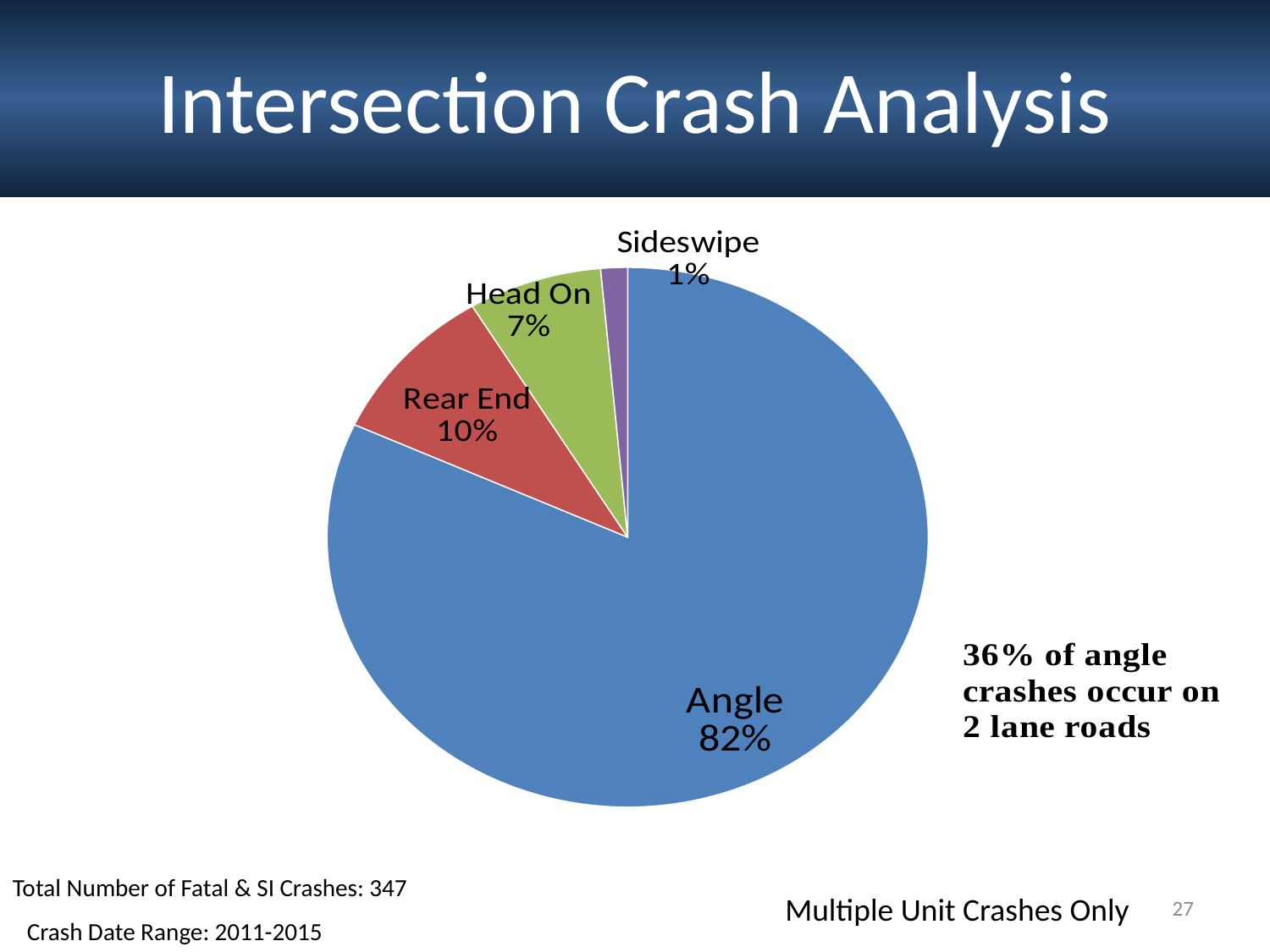
How many slices does the pie chart have? 4 Which crash type has the smallest slice of the pie? Sideswipe What share of the pie does Head On represent? 7% What is the difference in percentage points between Head On and Sideswipe? 6 What colour is the Angle slice of the pie? blue What share of the pie does Rear End represent? 10% What kind of chart is shown on the slide? pie chart What share of the pie does Angle represent? 82% What is the difference in percentage points between Angle and Rear End? 72 Which is larger, the Rear End slice or the Head On slice? Rear End Which crash type has the largest slice of the pie? Angle